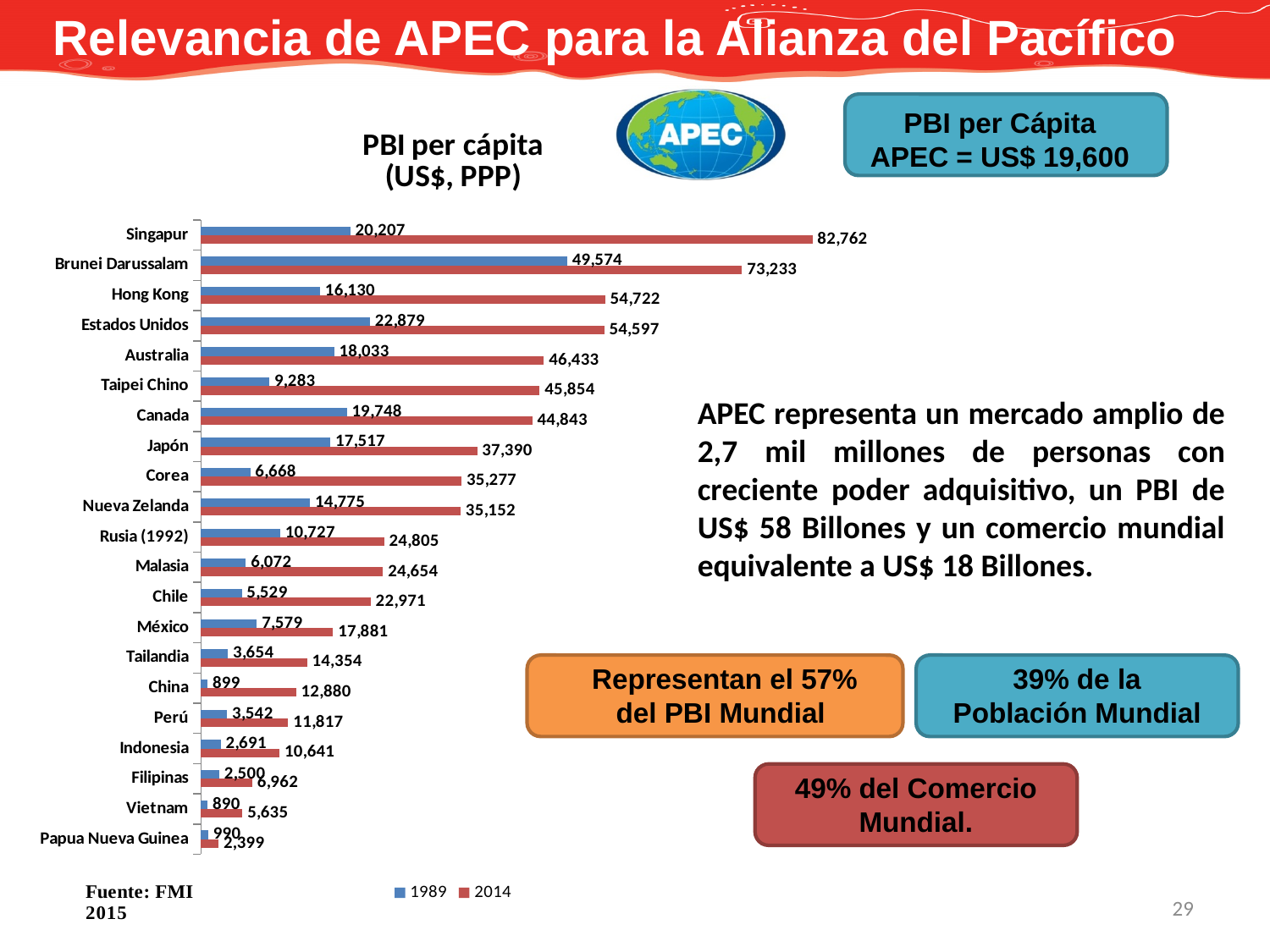
How many series does the chart legend list? 2 What is the 2014 PBI per cápita value for Singapur? 82,762 What is the 1989 PBI per cápita value for Chile? 5,529 What is the difference between Singapur's 2014 and 1989 PBI per cápita values? 62,555 Which economy has the highest 1989 PBI per cápita? Brunei Darussalam How many countries/economies are shown in the chart? 21 What is the 2014 PBI per cápita value for Perú? 11,817 What are the two series named in the chart legend? 1989 and 2014 Which economy has the lowest 2014 PBI per cápita? Papua Nueva Guinea Which has the larger 2014 PBI per cápita, Chile or México? Chile What kind of chart is shown on the slide? bar chart Which economy has the highest 2014 PBI per cápita? Singapur